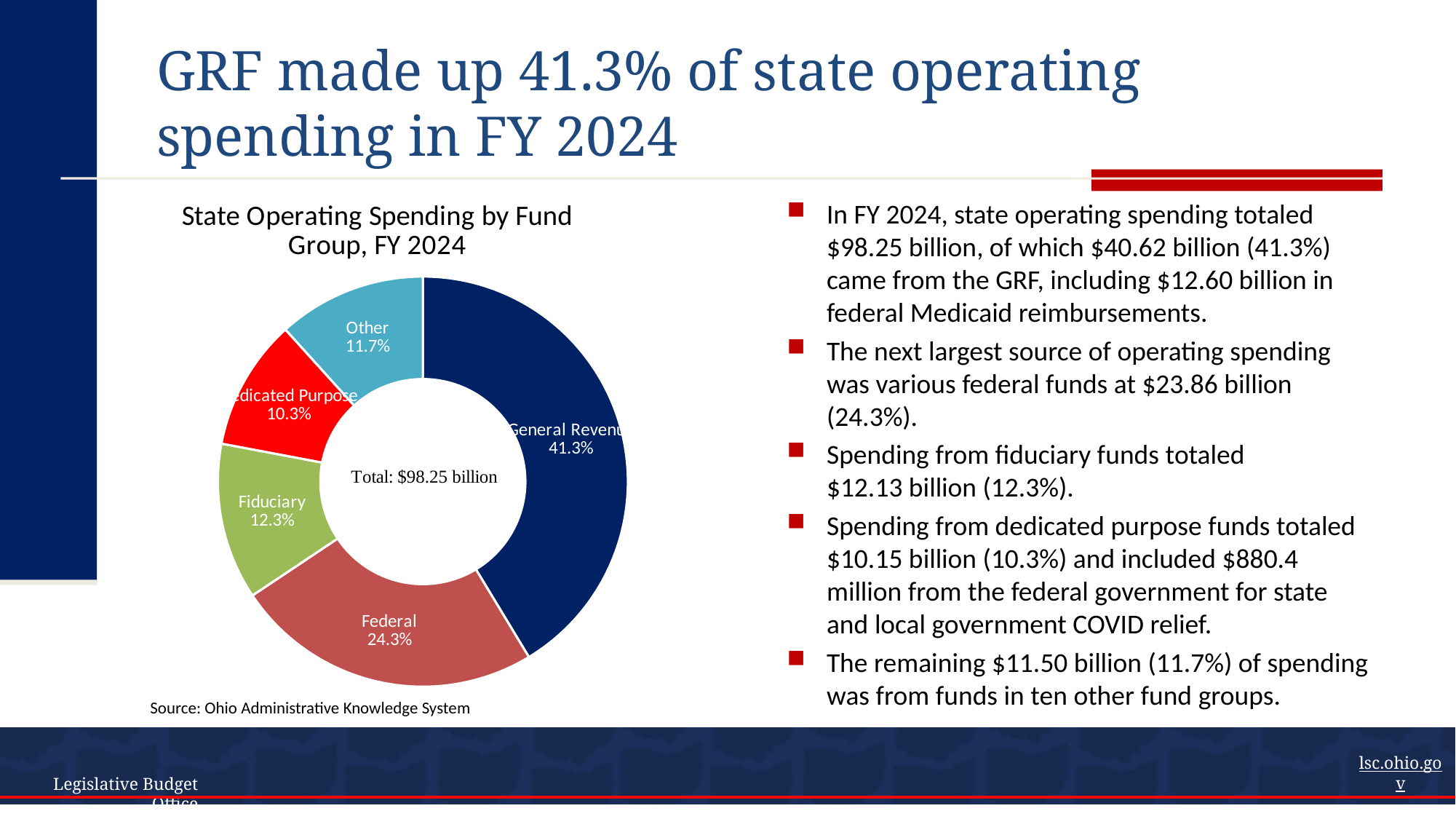
How many percentage points larger is the General Revenue share than the Federal share? 17 percentage points What total amount is printed in the centre of the donut chart? Total: $98.25 billion How many fund groups are shown in the donut chart? 5 Which fund group has the largest share of state operating spending in the chart? General Revenue What share does the Fiduciary slice represent? 12.3% What share of state operating spending came from the General Revenue fund group in FY 2024? 41.3% What type of chart is used to show state operating spending by fund group? Donut (pie) chart What percentage of the donut chart is labelled Federal? 24.3% What share of spending is labelled Other in the chart? 11.7% What percentage is shown for the Dedicated Purpose slice? 10.3% Which fund group has the smallest share in the chart? Dedicated Purpose Which slice is larger, Fiduciary or Other? Fiduciary